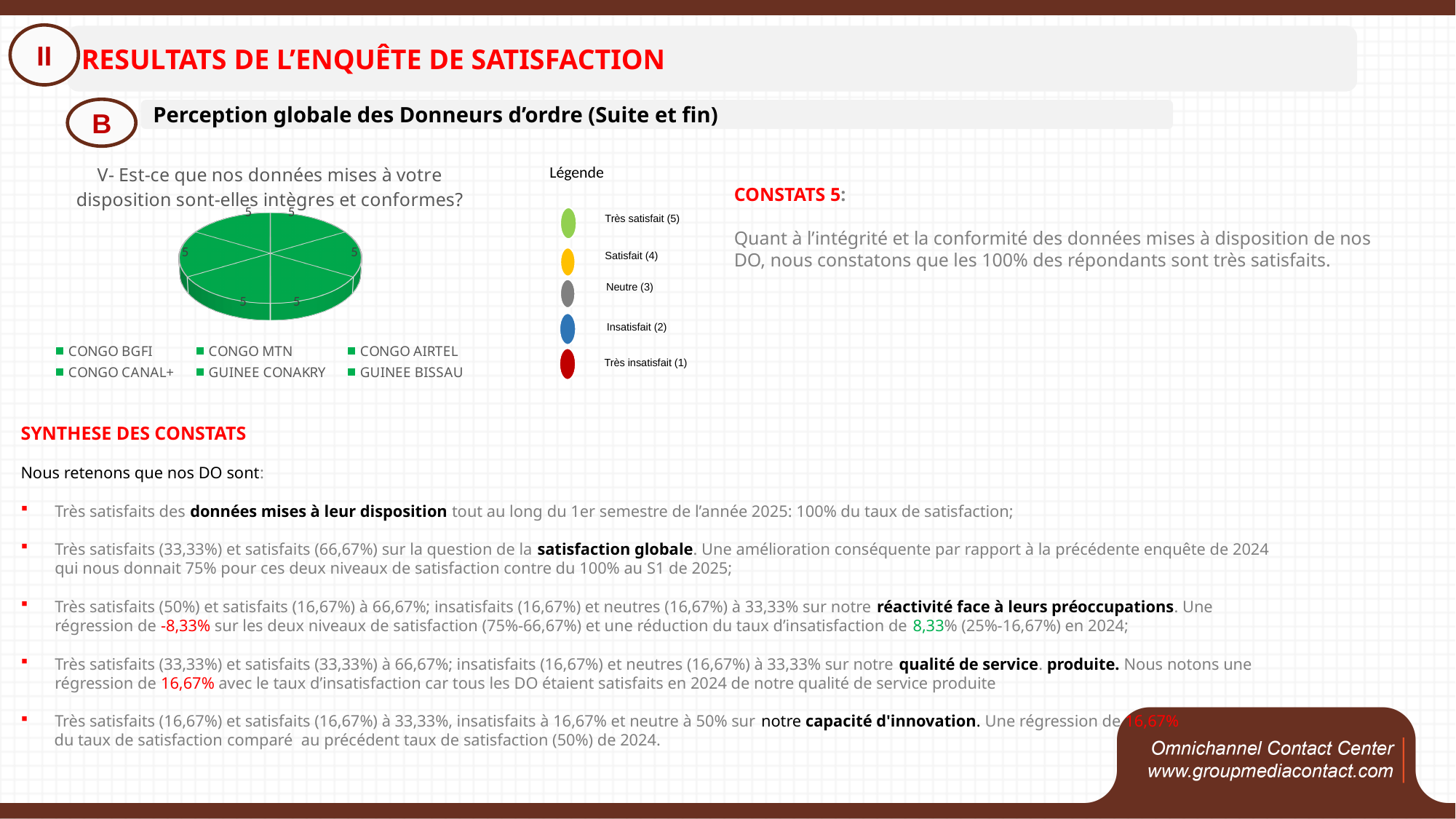
What is the total of all the slice values in the pie chart? 30 What colour are the slices of the pie chart? green What kind of chart is shown on the slide? pie chart What is the value shown for GUINEE BISSAU in the pie chart? 5 What is the difference between the values for CONGO MTN and CONGO CANAL+ in the pie chart? 0 What is the value shown for GUINEE CONAKRY in the pie chart? 5 Which question does the pie chart's title say it reports on? V- Est-ce que nos données mises à votre disposition sont-elles intègres et conformes? What is the value shown for CONGO AIRTEL in the pie chart? 5 What is the value shown for CONGO BGFI in the pie chart? 5 How many slices does the pie chart have? 6 How many entries does the pie chart's legend list? 6